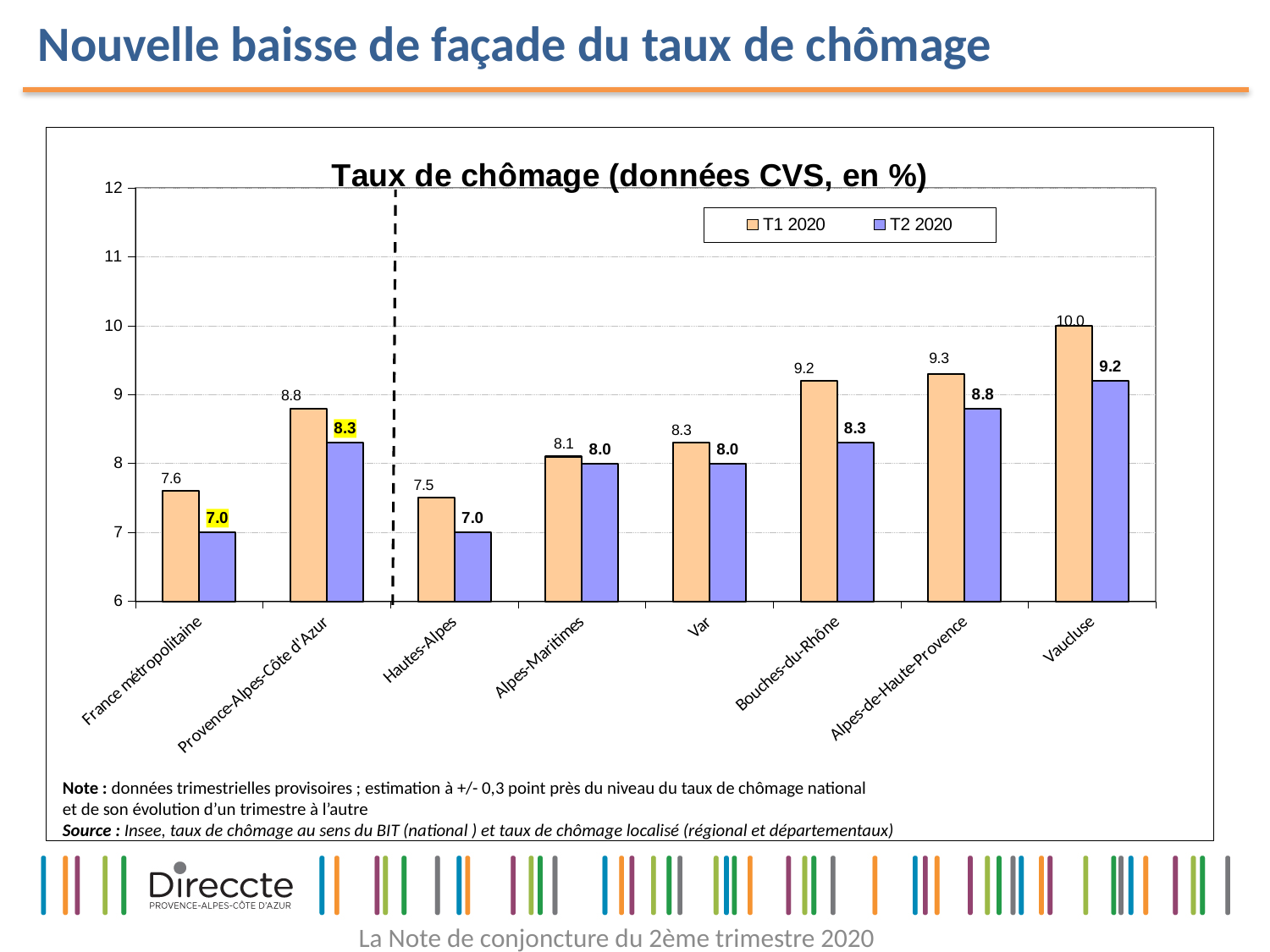
Is the T1 2020 value for Alpes-de-Haute-Provence greater or less than 9? greater What is the T2 2020 unemployment rate for Provence-Alpes-Côte d'Azur? 8.3 What kind of chart is shown on the slide? Bar chart What is the T2 2020 value for Bouches-du-Rhône? 8.3 What is the title of the chart? Taux de chômage (données CVS, en %) Which is larger: the T2 2020 value for Alpes-de-Haute-Provence or the T2 2020 value for Var? Alpes-de-Haute-Provence Which category has the highest T1 2020 unemployment rate? Vaucluse How many series does the legend list? 2 What is the difference between the T1 2020 and T2 2020 values for Bouches-du-Rhône? 0.9 What is the T1 2020 unemployment rate for Vaucluse? 10.0 Which category has the lowest T1 2020 unemployment rate? Hautes-Alpes How many categories are shown on the x axis? 8